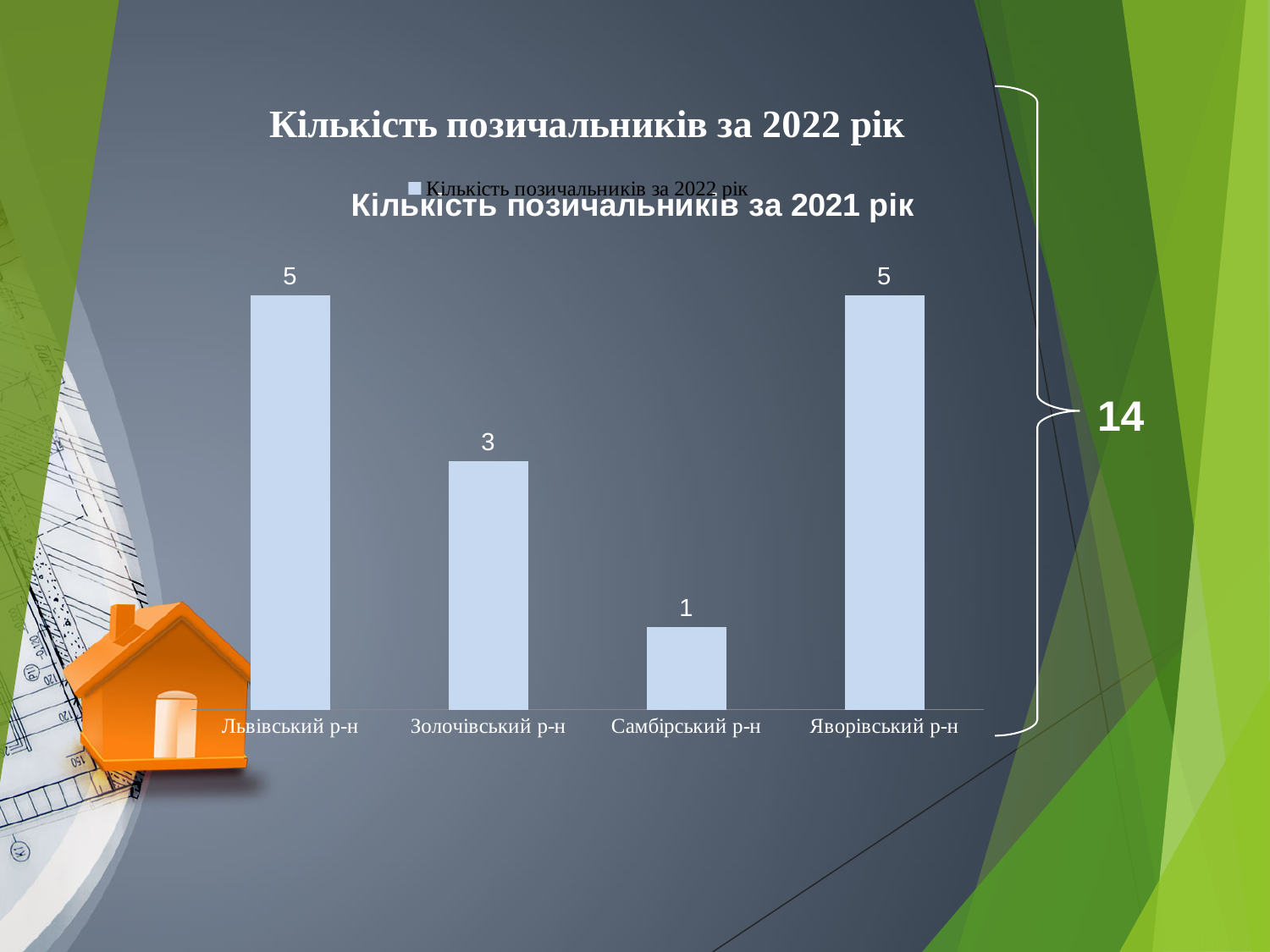
How many series does the legend list? 1 What is the total of all four district values shown on the slide? 14 How many districts are shown on the chart? 4 Which is larger, the value for Золочівський р-н or the value for Самбірський р-н? Золочівський р-н What is the value for Самбірський р-н? 1 What kind of chart is shown on the slide? bar chart What is the difference between the values for Львівський р-н and Золочівський р-н? 2 What is the difference between the values for Яворівський р-н and Самбірський р-н? 4 What is the value for Яворівський р-н? 5 Which district has the lowest value? Самбірський р-н What is the value for Золочівський р-н? 3 What is the value for Львівський р-н? 5